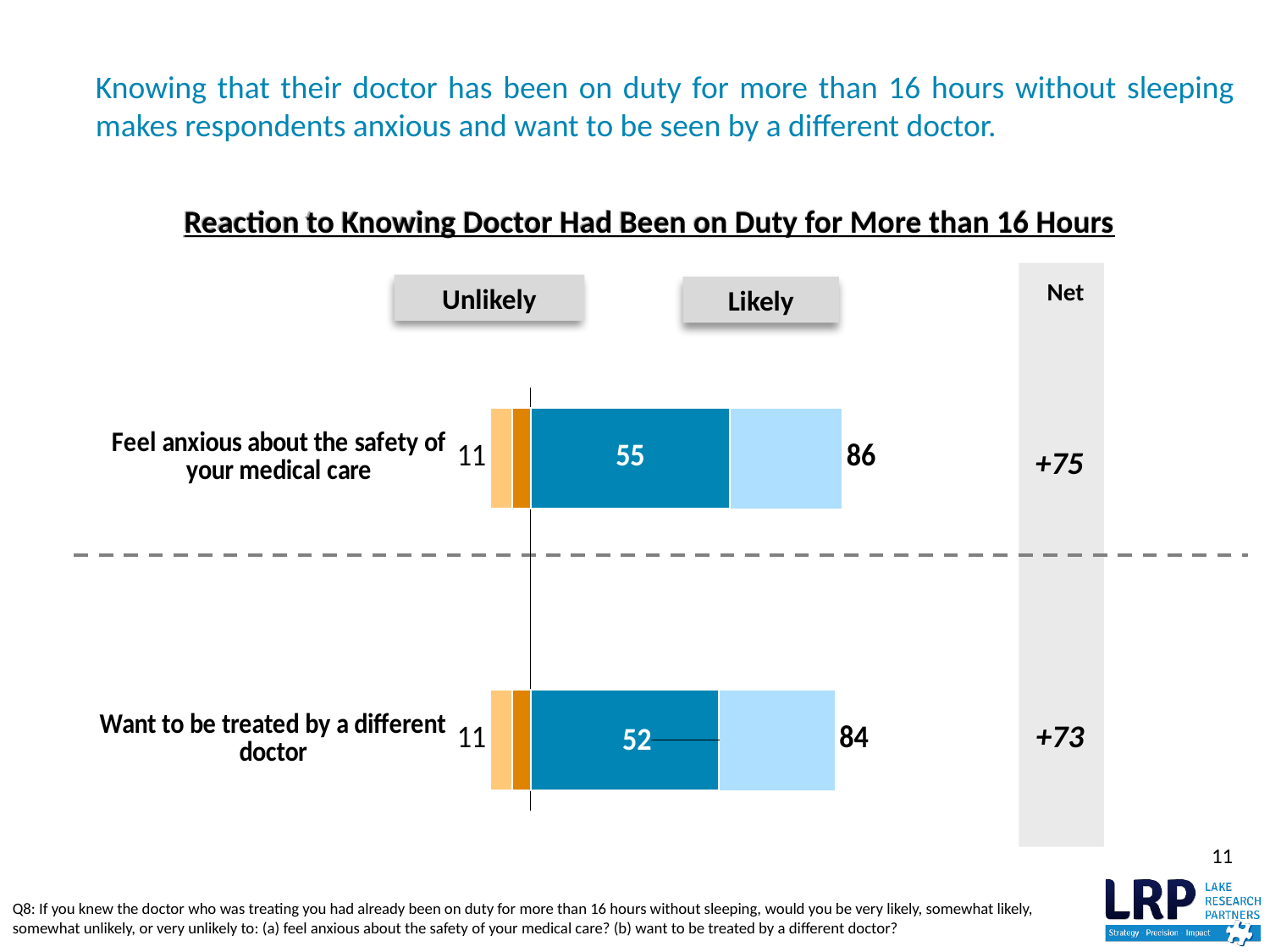
What type of chart is shown on the slide? Bar chart What is the Net value for 'Feel anxious about the safety of your medical care'? +75 What is the title of the chart? Reaction to Knowing Doctor Had Been on Duty for More than 16 Hours What are the two column headings shown above the bars? Unlikely and Likely Which item has the higher total 'Likely' value? Feel anxious about the safety of your medical care What is the 'Unlikely' value for 'Feel anxious about the safety of your medical care'? 11 What is the Net value for 'Want to be treated by a different doctor'? +73 What value is printed inside the dark blue segment for 'Want to be treated by a different doctor'? 52 What is the total 'Likely' value for 'Want to be treated by a different doctor'? 84 What is the total 'Likely' value for 'Feel anxious about the safety of your medical care'? 86 How many categories (response items) are plotted in the chart? 2 What is the difference between the total 'Likely' values for 'Feel anxious about the safety of your medical care' and 'Want to be treated by a different doctor'? 2